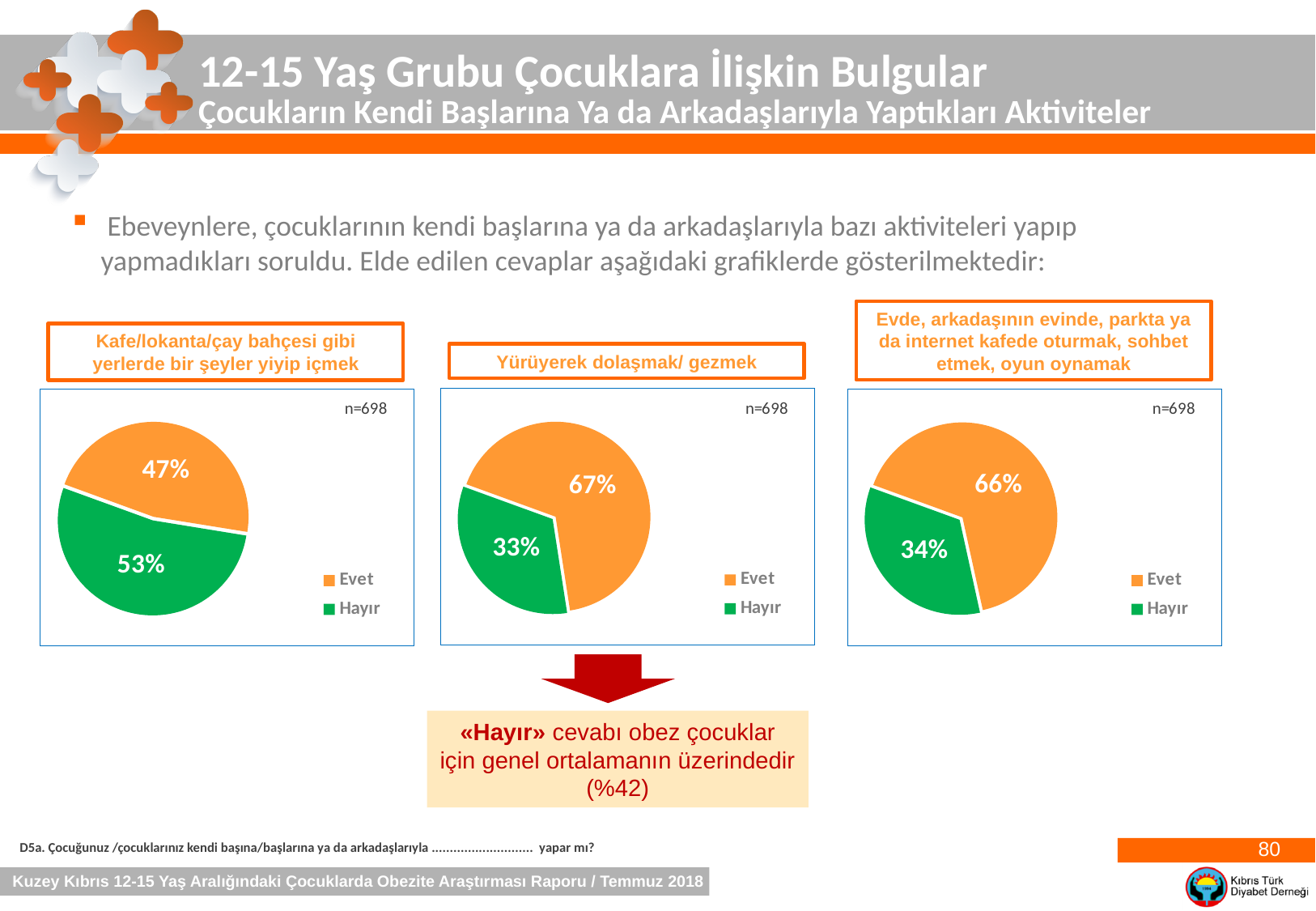
In the 'Yürüyerek dolaşmak/ gezmek' chart, which slice is the largest? Evet How many entries does the legend of the 'Yürüyerek dolaşmak/ gezmek' chart list? 2 In the 'Evde, arkadaşının evinde, parkta ya da internet kafede oturmak, sohbet etmek, oyun oynamak' chart, which slice is the smallest? Hayır In the 'Yürüyerek dolaşmak/ gezmek' chart, what is the value for Hayır? 33% In the 'Yürüyerek dolaşmak/ gezmek' chart, what is the difference between the Evet and Hayır values? 34% In the 'Kafe/lokanta/çay bahçesi gibi yerlerde bir şeyler yiyip içmek' chart, what is the value for Evet? 47% In the 'Kafe/lokanta/çay bahçesi gibi yerlerde bir şeyler yiyip içmek' chart, what is the value for Hayır? 53% In the 'Kafe/lokanta/çay bahçesi gibi yerlerde bir şeyler yiyip içmek' chart, which slice is larger, Evet or Hayır? Hayır In the 'Evde, arkadaşının evinde, parkta ya da internet kafede oturmak, sohbet etmek, oyun oynamak' chart, what is the value for Evet? 66% In the 'Evde, arkadaşının evinde, parkta ya da internet kafede oturmak, sohbet etmek, oyun oynamak' chart, what is the value for Hayır? 34% What kind of chart is the 'Kafe/lokanta/çay bahçesi gibi yerlerde bir şeyler yiyip içmek' chart? Pie chart In the 'Yürüyerek dolaşmak/ gezmek' chart, what is the value for Evet? 67%